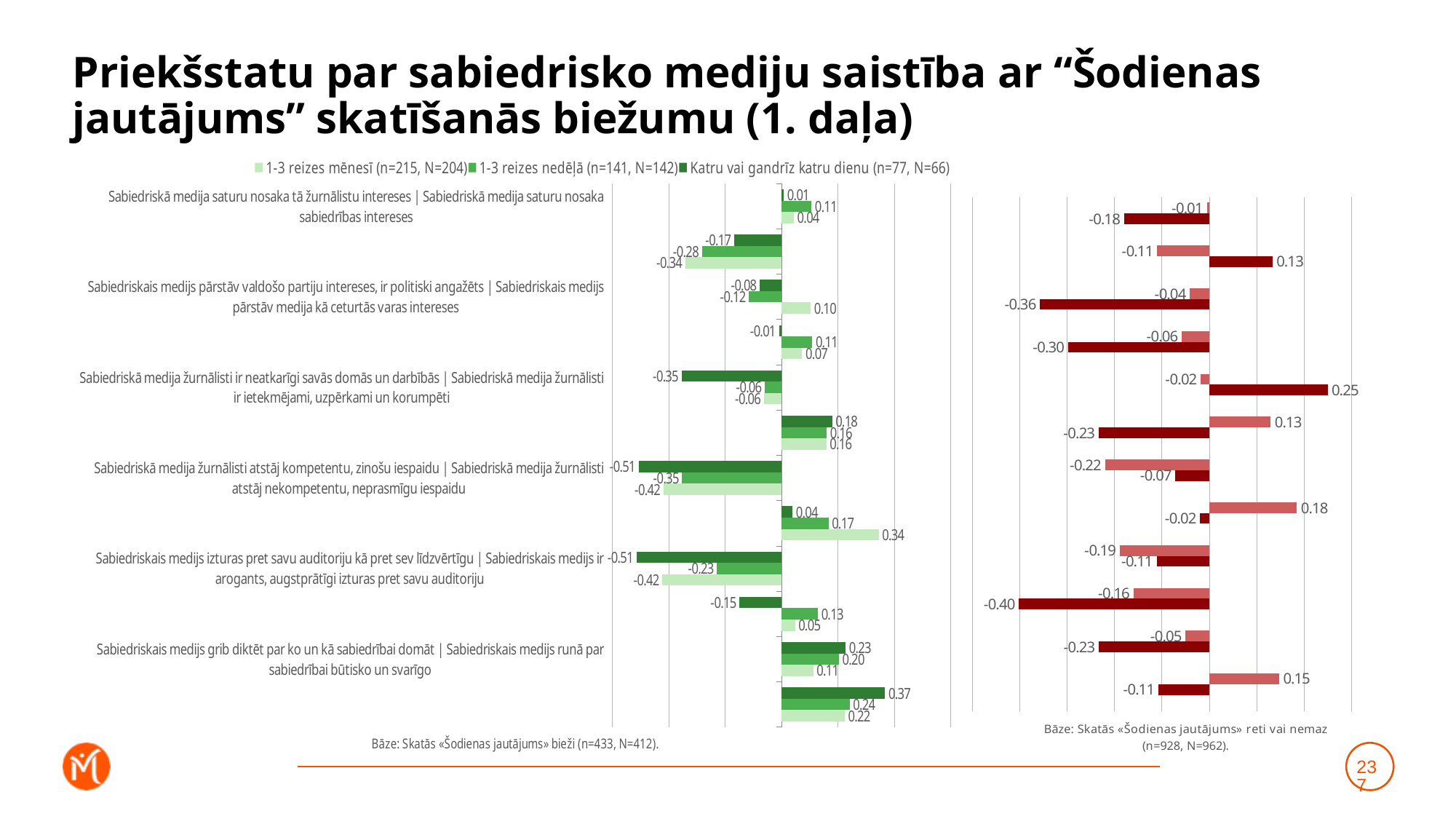
In the left (green) chart, what is the highest value labelled on any bar? 0.37 According to the base note under the right (red) chart, what are the n and N values? n=928, N=962 What is the first legend entry above the left (green) chart? 1-3 reizes mēnesī (n=215, N=204) How many groups of bars are plotted in the right (red) chart? 12 In the left (green) chart, what is the lowest value labelled on any bar? -0.51 In the right (red) chart, what is the highest value labelled on any bar? 0.25 How many groups of bars are plotted in the left (green) chart? 12 How many series does the legend above the left (green) chart list? 3 In the left (green) chart, what is the difference between the highest labelled value (0.37) and the lowest labelled value (-0.51)? 0.88 Which is larger: the highest value in the left (green) chart or the highest value in the right (red) chart? the left (green) chart, 0.37 What kind of chart is shown on the left side of the slide (the green chart)? bar chart In the right (red) chart, what is the lowest value labelled on any bar? -0.40